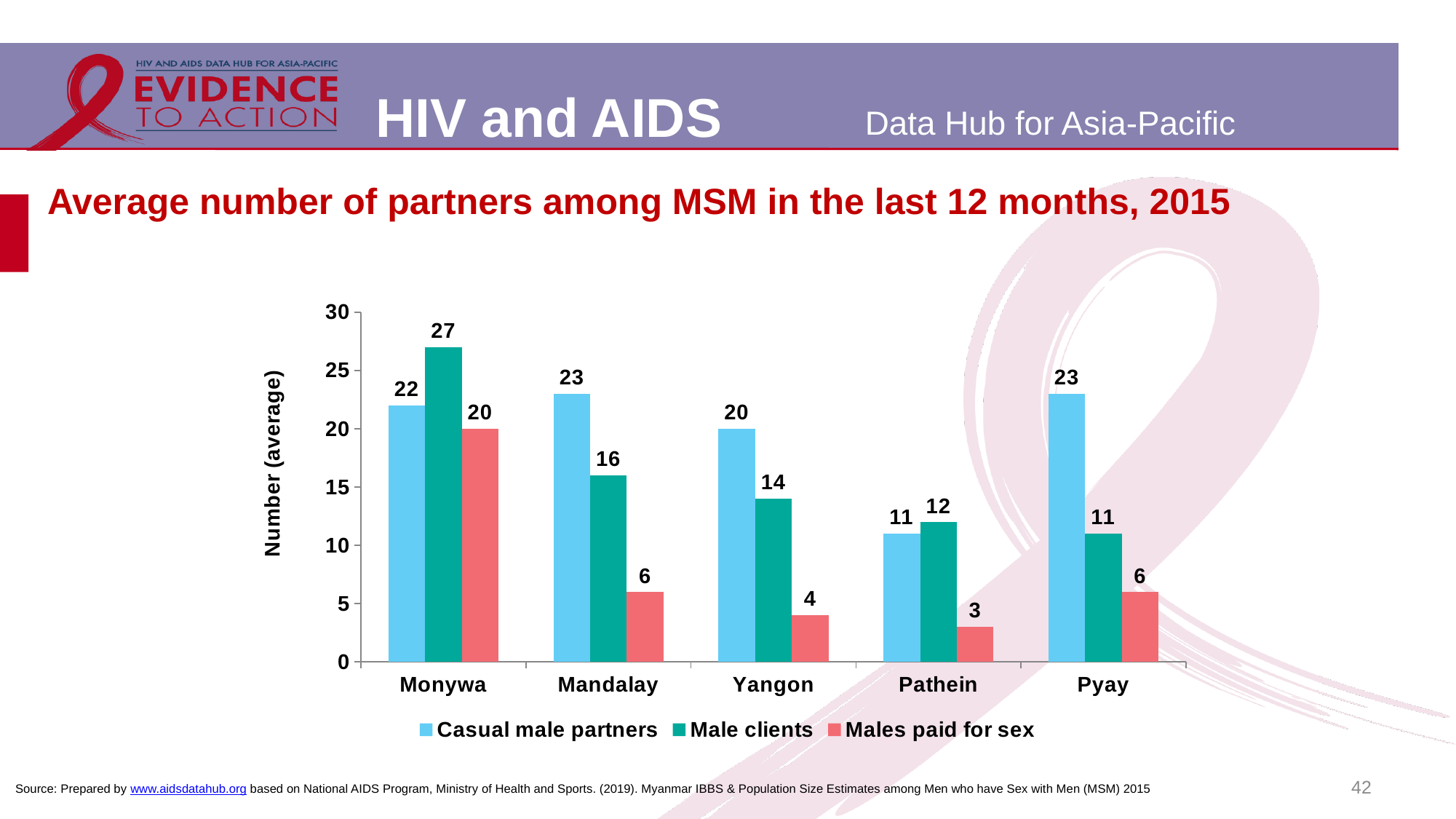
Which city has the highest average number of male clients? Monywa How many series does the legend list? 3 What kind of chart is shown on the slide? Bar chart What is the average number of casual male partners among MSM in Monywa? 22 What is the title of the chart? Average number of partners among MSM in the last 12 months, 2015 What is the label of the y axis? Number (average) Which city has the lowest average number of males paid for sex? Pathein How many cities are shown on the x axis of the chart? 5 In Pathein, which is larger: the average number of casual male partners or male clients? Male clients What is the average number of male clients among MSM in Mandalay? 16 What is the difference between the average number of casual male partners and male clients in Pyay? 12 What is the average number of males paid for sex among MSM in Yangon? 4